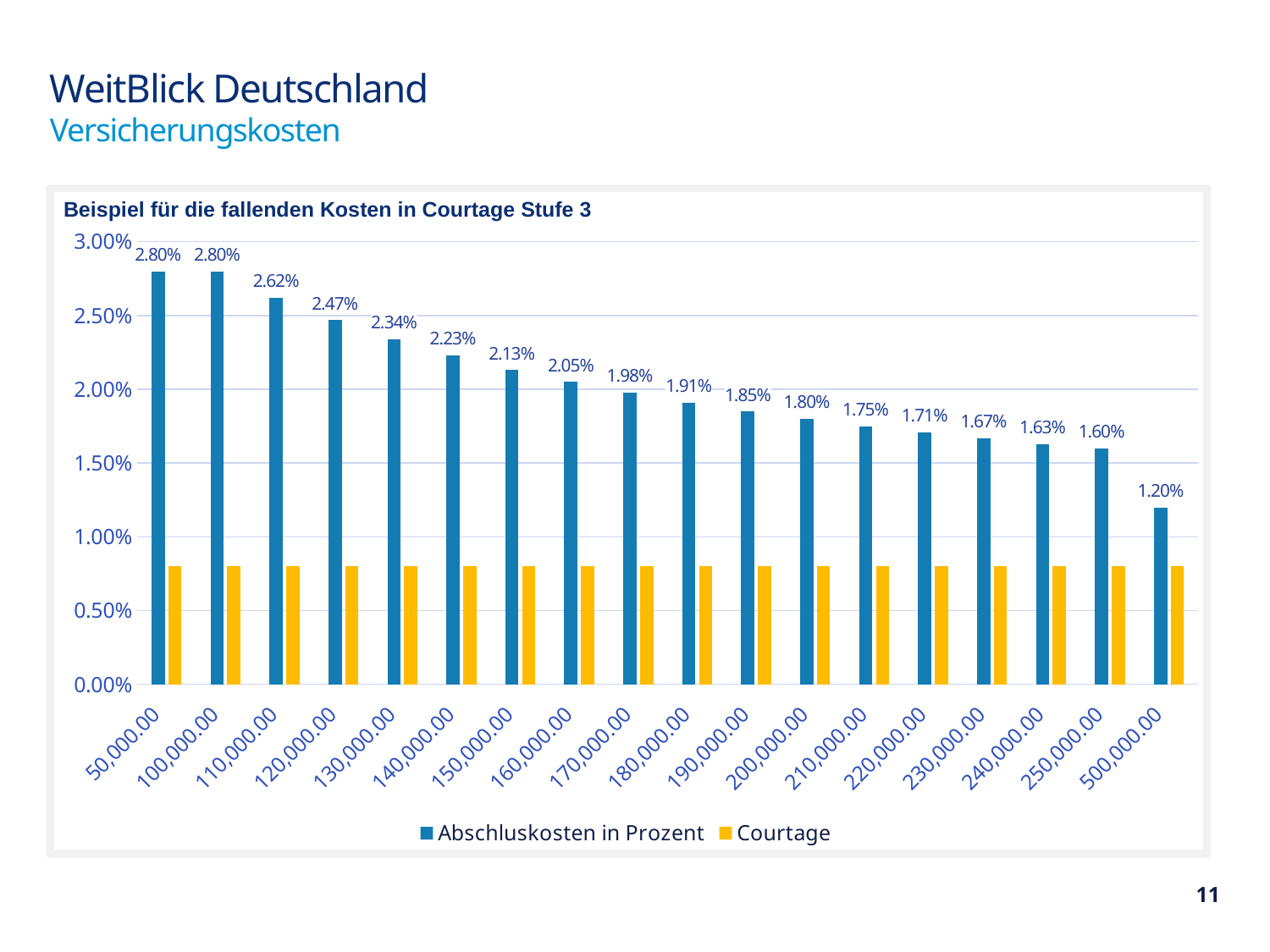
Is the Courtage value for 50,000.00 greater or less than 0.50%? greater Which category has the lowest Abschluskosten in Prozent? 500,000.00 How many categories are shown on the x axis? 18 What is the value of Abschluskosten in Prozent for 120,000.00? 2.47% What is the difference in Abschluskosten in Prozent between 110,000.00 and 250,000.00? 1.02% Which is larger, the Abschluskosten in Prozent for 150,000.00 or for 190,000.00? 150,000.00 Do the Abschluskosten in Prozent values rise or fall from left to right along the x axis? Fall Is the Courtage value for 140,000.00 greater or less than 1.00%? less How many series does the legend list? 2 What is the value of Abschluskosten in Prozent for 500,000.00? 1.20% What is the value of Abschluskosten in Prozent for 200,000.00? 1.80% What kind of chart is shown on the slide? Bar chart